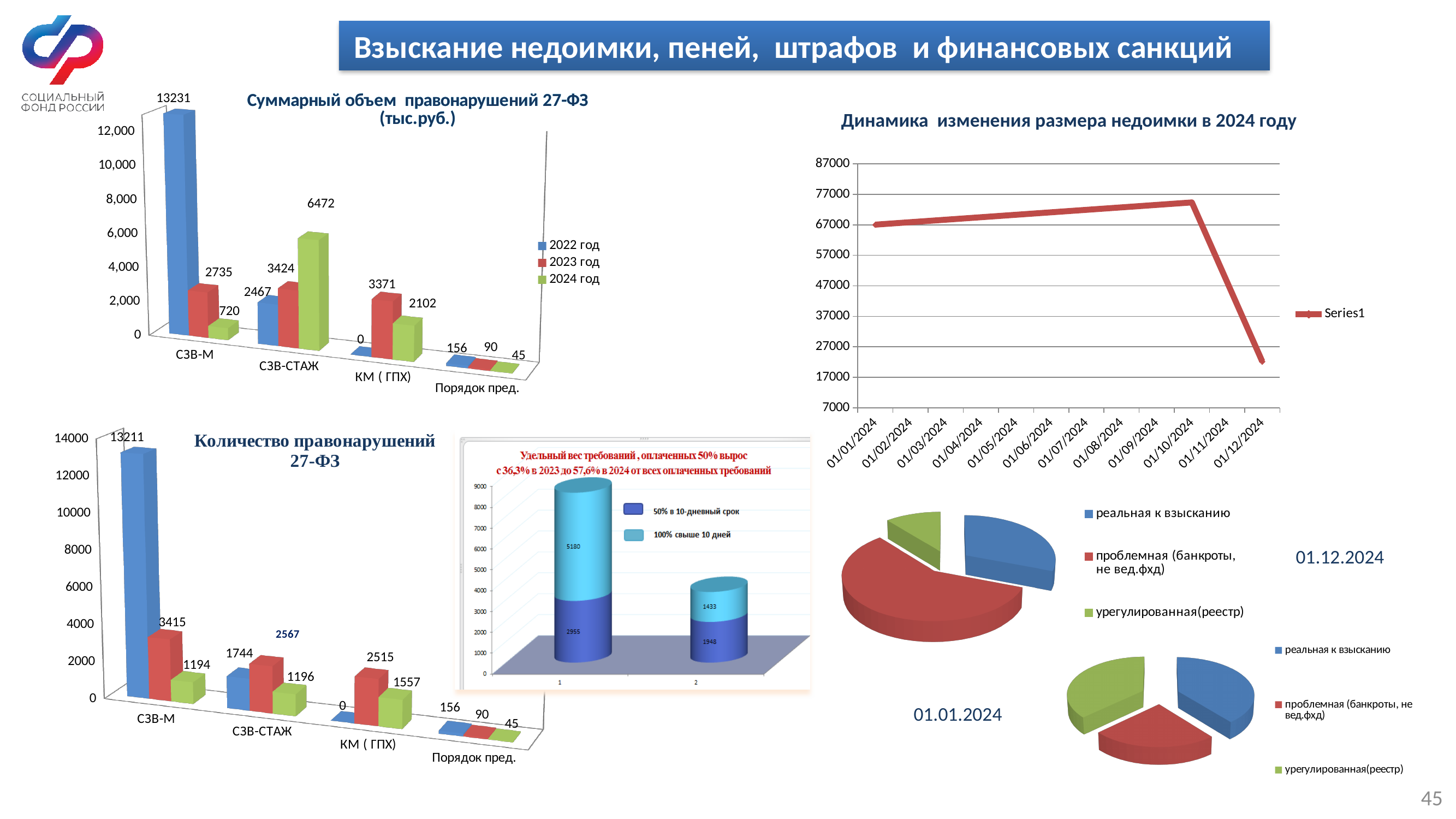
What kind of chart is used for the data dated 01.12.2024 and 01.01.2024 on the right of the slide? pie chart How many categories are shown on the x axis of the chart 'Количество правонарушений 27-ФЗ'? 4 In the chart 'Количество правонарушений 27-ФЗ', which is larger for СЗВ-СТАЖ: the blue bar (1744) or the green bar (1196)? the blue bar (1744) In the chart 'Динамика изменения размера недоимки в 2024 году', is the value at 01/12/2024 greater or less than 27000? less In the stacked bar chart in the middle of the slide (Удельный вес требований), what is the total of the stacked bar for category 1? 8135 In the chart 'Суммарный объем правонарушений 27-ФЗ (тыс.руб.)', what is the difference between the 2023 год and 2024 год values for КМ (ГПХ)? 1269 In the chart 'Количество правонарушений 27-ФЗ', what is the value of the red (2023) bar for КМ (ГПХ)? 2515 In the chart 'Суммарный объем правонарушений 27-ФЗ (тыс.руб.)', which category has the highest value for 2023 год? СЗВ-СТАЖ In the chart 'Суммарный объем правонарушений 27-ФЗ (тыс.руб.)', what is the value for СЗВ-СТАЖ in 2024 год? 6472 What kind of chart is 'Динамика изменения размера недоимки в 2024 году'? line chart In the chart 'Суммарный объем правонарушений 27-ФЗ (тыс.руб.)', what is the value for СЗВ-М in 2022 год? 13231 How many series does the legend of the chart 'Суммарный объем правонарушений 27-ФЗ (тыс.руб.)' list? 3